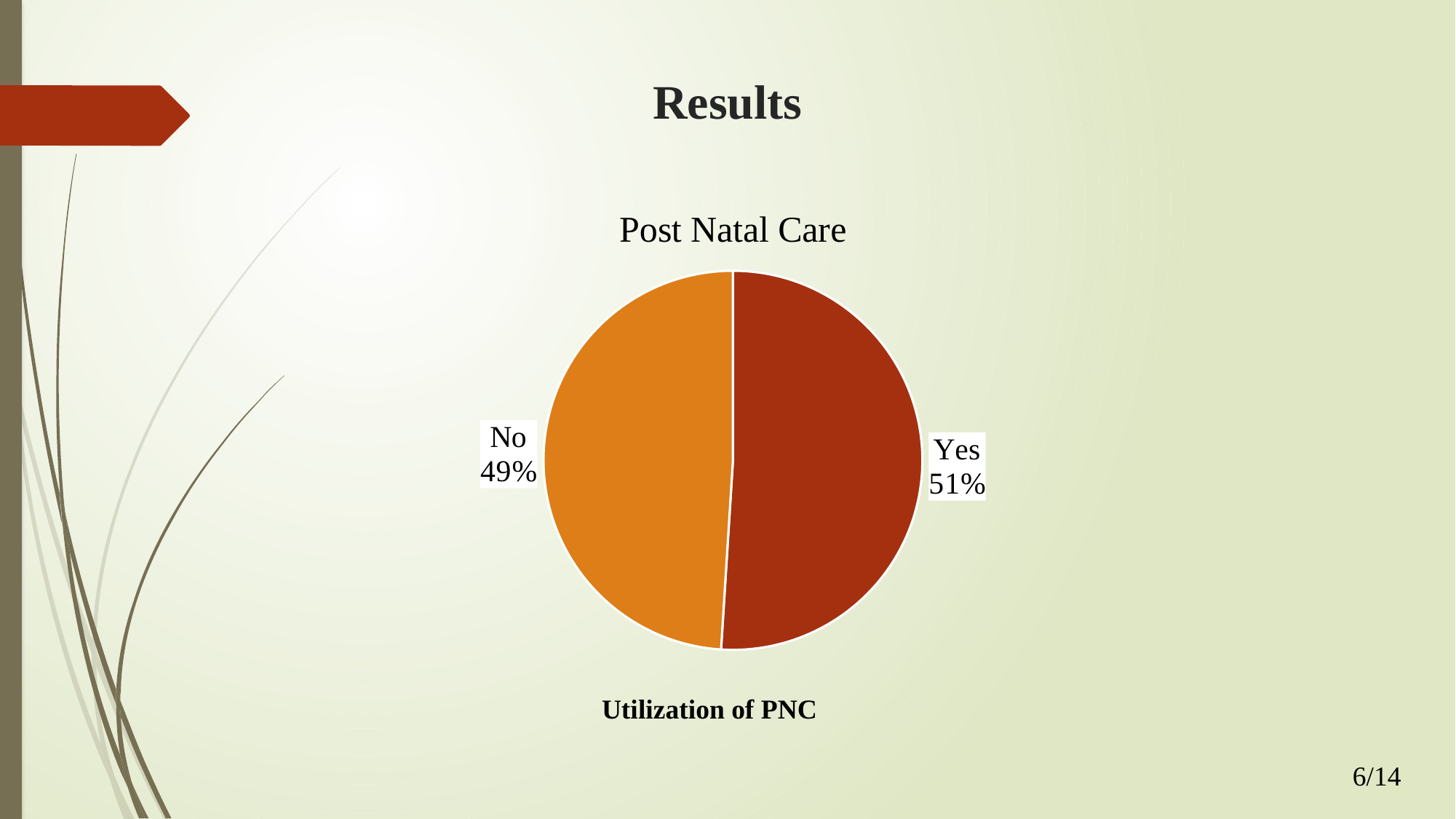
What is the difference in percentage points between the "Yes" and "No" slices? 2% Is the share for "No" greater or less than 50%? less Which slice is larger, "Yes" or "No"? Yes Is the share for "Yes" greater or less than 50%? greater Which category has the smallest share of the pie? No What share of the pie does the "No" slice represent? 49% What is the chart's title? Post Natal Care What caption appears below the pie chart? Utilization of PNC How many slices does the pie chart have? 2 Which category has the largest share of the pie? Yes What share of the pie does the "Yes" slice represent? 51% What type of chart is shown on the slide? pie chart